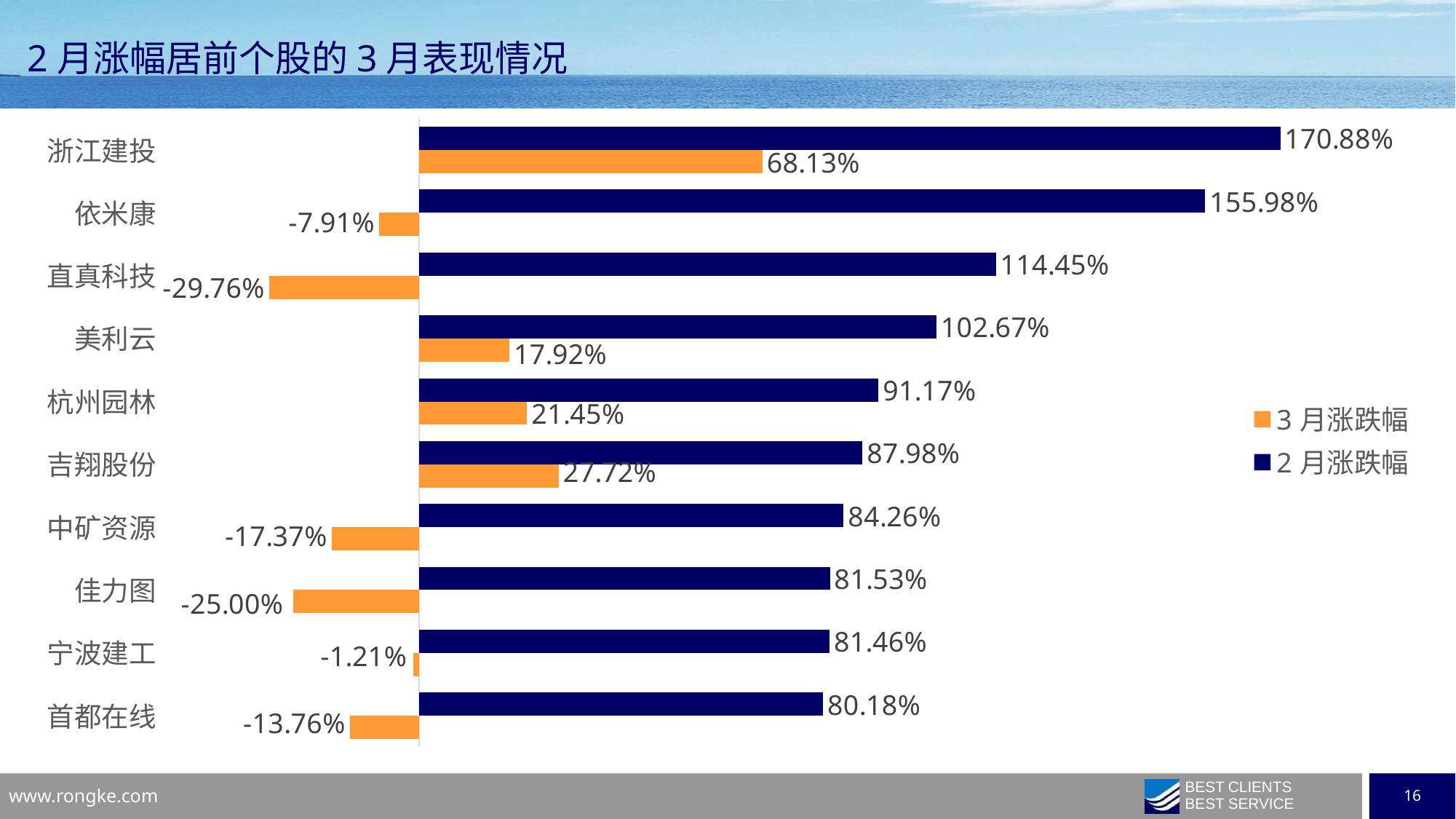
What is the 3月涨跌幅 value for 直真科技? -29.76% What type of chart is shown on the slide? Bar chart Which stock has the lowest 2月涨跌幅? 首都在线 What is the 2月涨跌幅 value for 浙江建投? 170.88% What is the 2月涨跌幅 value for 宁波建工? 81.46% How many stocks are shown in the chart? 10 Which stock has the lowest 3月涨跌幅? 直真科技 Which stock has the highest 3月涨跌幅? 浙江建投 What is the difference between the 2月涨跌幅 and 3月涨跌幅 values for 浙江建投? 102.75% What is the 3月涨跌幅 value for 吉翔股份? 27.72% Which is larger: the 3月涨跌幅 for 杭州园林 or for 美利云? 杭州园林 How many series does the legend list? 2